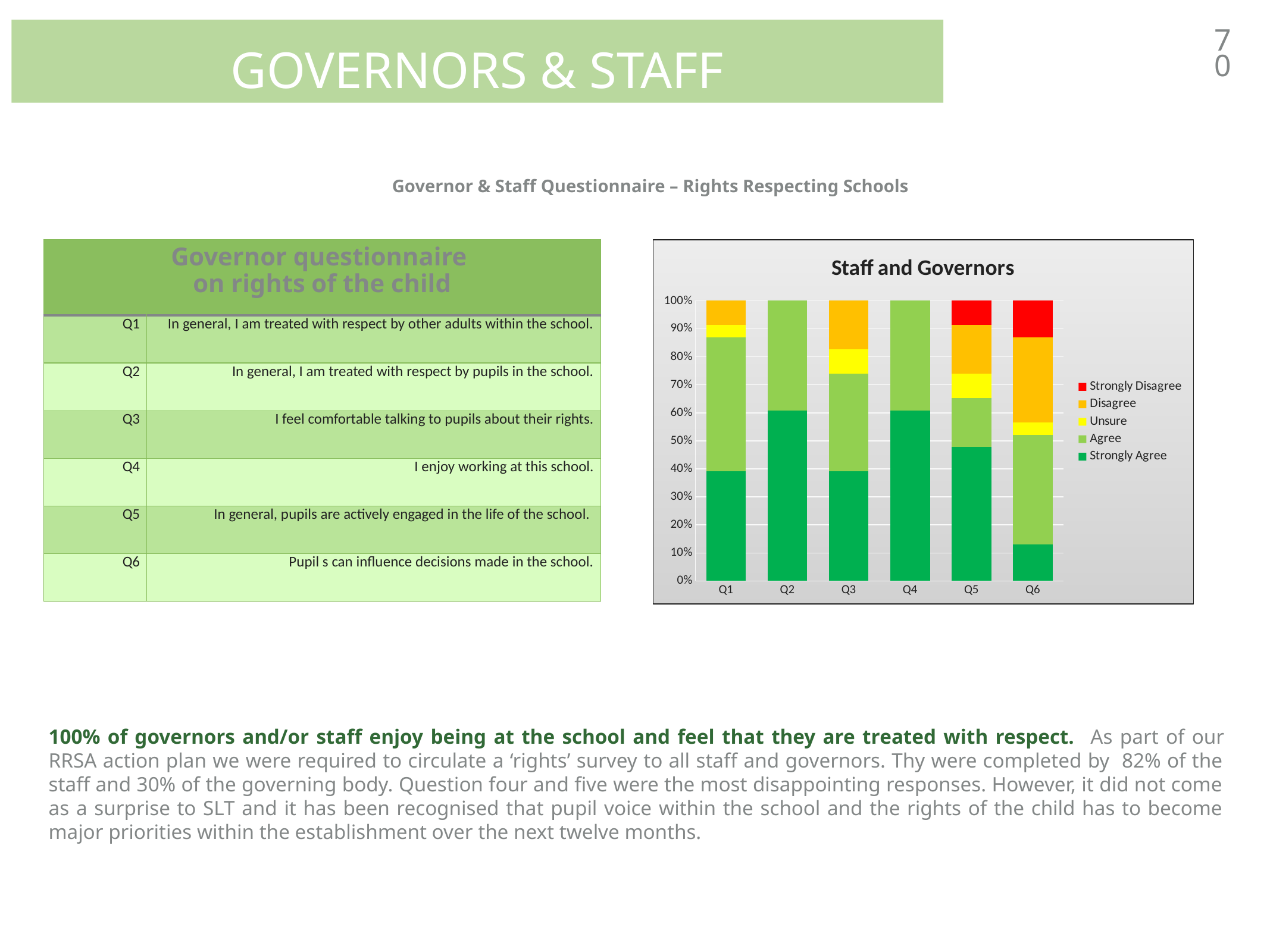
In the "Staff and Governors" chart, which questions include a "Strongly Disagree" segment? Q5 and Q6 How many series does the legend of the "Staff and Governors" chart list? 5 In the "Staff and Governors" chart, which question has the lowest "Strongly Agree" share? Q6 In the "Staff and Governors" chart, is the "Strongly Agree" share for Q6 greater or less than 20%? less How many questions (categories) are shown on the x axis of the "Staff and Governors" chart? 6 In the "Staff and Governors" chart, is the "Strongly Agree" share for Q1 greater or less than 50%? less What kind of chart is the "Staff and Governors" chart? Stacked bar chart In the "Staff and Governors" chart, which has the larger "Strongly Agree" share, Q5 or Q1? Q5 In the "Staff and Governors" chart, is the "Strongly Agree" share for Q2 greater or less than 50%? greater In the "Staff and Governors" chart, which has the larger "Strongly Agree" share, Q2 or Q6? Q2 Which colour represents "Strongly Disagree" in the "Staff and Governors" chart? Red What is the title of the chart on the slide? Staff and Governors